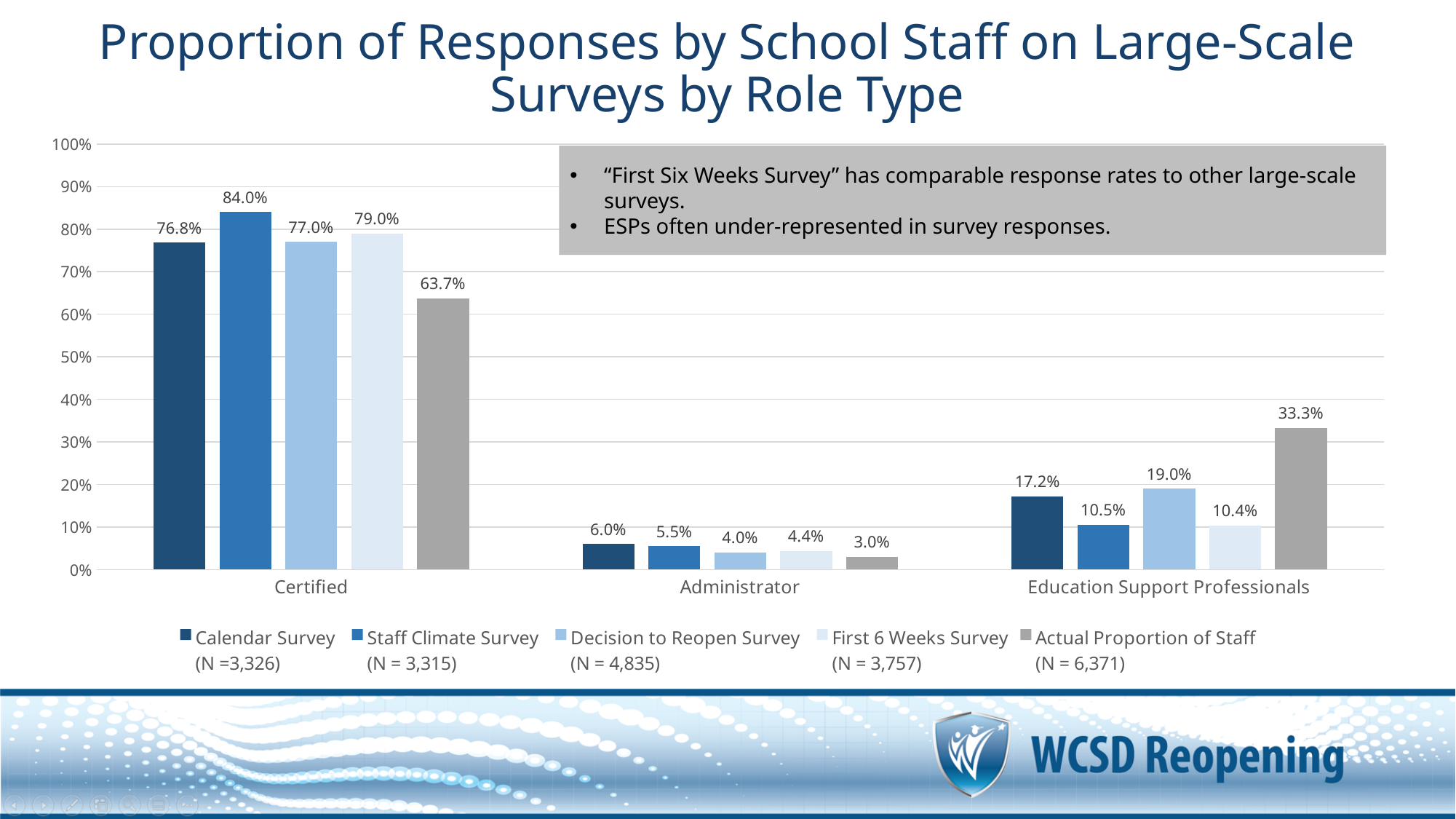
What is the First 6 Weeks Survey value for Administrator? 4.4% Which category has the highest Calendar Survey value? Certified Which is larger for Certified: the Decision to Reopen Survey value or the First 6 Weeks Survey value? First 6 Weeks Survey How many series does the legend list? 5 How many role type categories are shown on the x axis? 3 What is the sample size (N) shown in the legend for the Decision to Reopen Survey? 4,835 What is the Staff Climate Survey value for Certified? 84.0% What kind of chart is shown on the slide? bar chart What is the Actual Proportion of Staff value for Education Support Professionals? 33.3% Which category has the lowest Decision to Reopen Survey value? Administrator Is the Actual Proportion of Staff value for Certified greater or less than 70%? less What is the difference between the Actual Proportion of Staff and the Calendar Survey values for Education Support Professionals? 16.1%